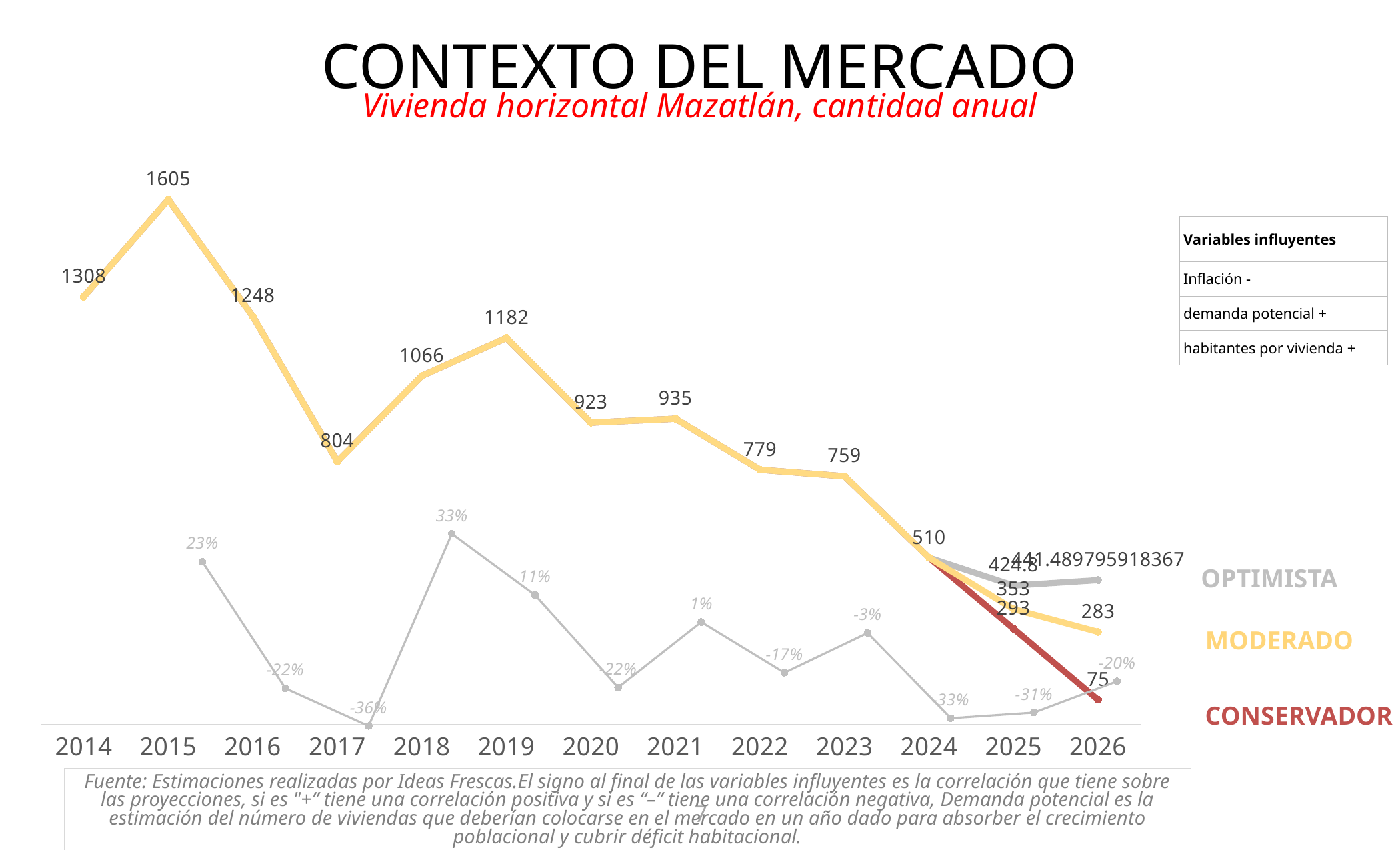
Do the values rise or fall from 2019 to 2024? fall How many years are shown on the x axis? 13 What is the difference between the values for 2015 and 2014? 297 What is the value for 2017? 804 What are the names of the three projection scenarios shown on the right of the chart? OPTIMISTA, MODERADO, CONSERVADOR Which year has the highest value on the main line? 2015 Which is larger, the value for 2020 or the value for 2021? 2021 What is the MODERADO scenario value for 2026? 283 What is the CONSERVADOR scenario value for 2026? 75 What is the value for 2015? 1605 What kind of chart is shown on the slide? line chart What is the value for 2024? 510